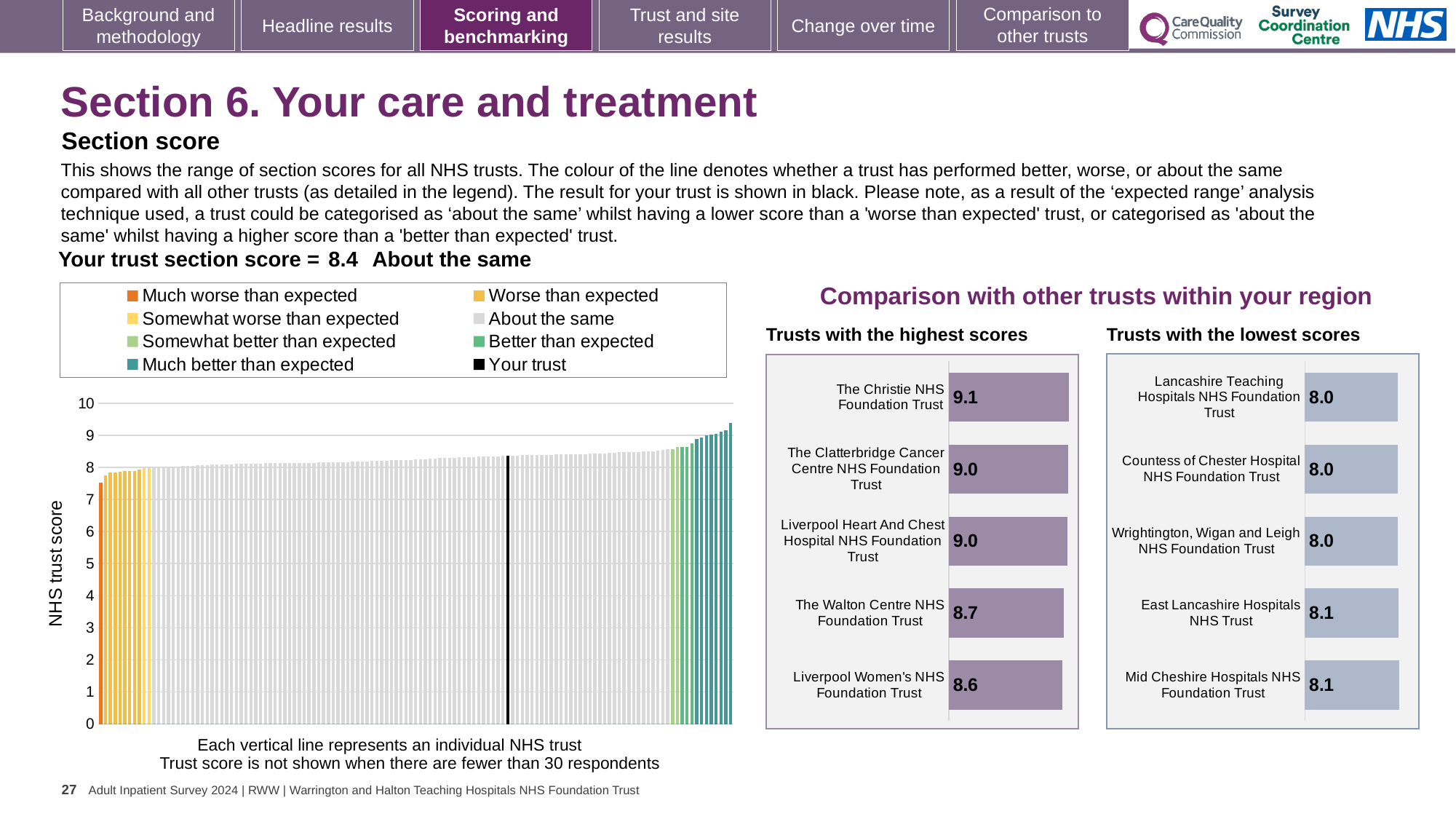
In the main chart on the left showing NHS trust scores, what kind of chart is it? Bar chart In the 'Trusts with the lowest scores' chart, what is the score for Mid Cheshire Hospitals NHS Foundation Trust? 8.1 In the main chart on the left showing NHS trust scores, do the values rise or fall from left to right? Rise In the 'Trusts with the highest scores' chart, what is the difference between the scores of The Christie NHS Foundation Trust and Liverpool Women's NHS Foundation Trust? 0.5 In the 'Trusts with the highest scores' chart, what is the score for The Walton Centre NHS Foundation Trust? 8.7 In the 'Trusts with the highest scores' chart, what is the score for The Christie NHS Foundation Trust? 9.1 In the 'Trusts with the lowest scores' chart, what is the difference between the scores of East Lancashire Hospitals NHS Trust and Lancashire Teaching Hospitals NHS Foundation Trust? 0.1 In the 'Trusts with the lowest scores' chart, how many trusts are shown? 5 In the main chart on the left showing NHS trust scores, how many entries does the legend list? 8 In the 'Trusts with the highest scores' chart, which trust has the highest score? The Christie NHS Foundation Trust In the 'Trusts with the highest scores' chart, which trust has the lowest score? Liverpool Women's NHS Foundation Trust In the 'Trusts with the lowest scores' chart, which has the larger score: East Lancashire Hospitals NHS Trust or Countess of Chester Hospital NHS Foundation Trust? East Lancashire Hospitals NHS Trust